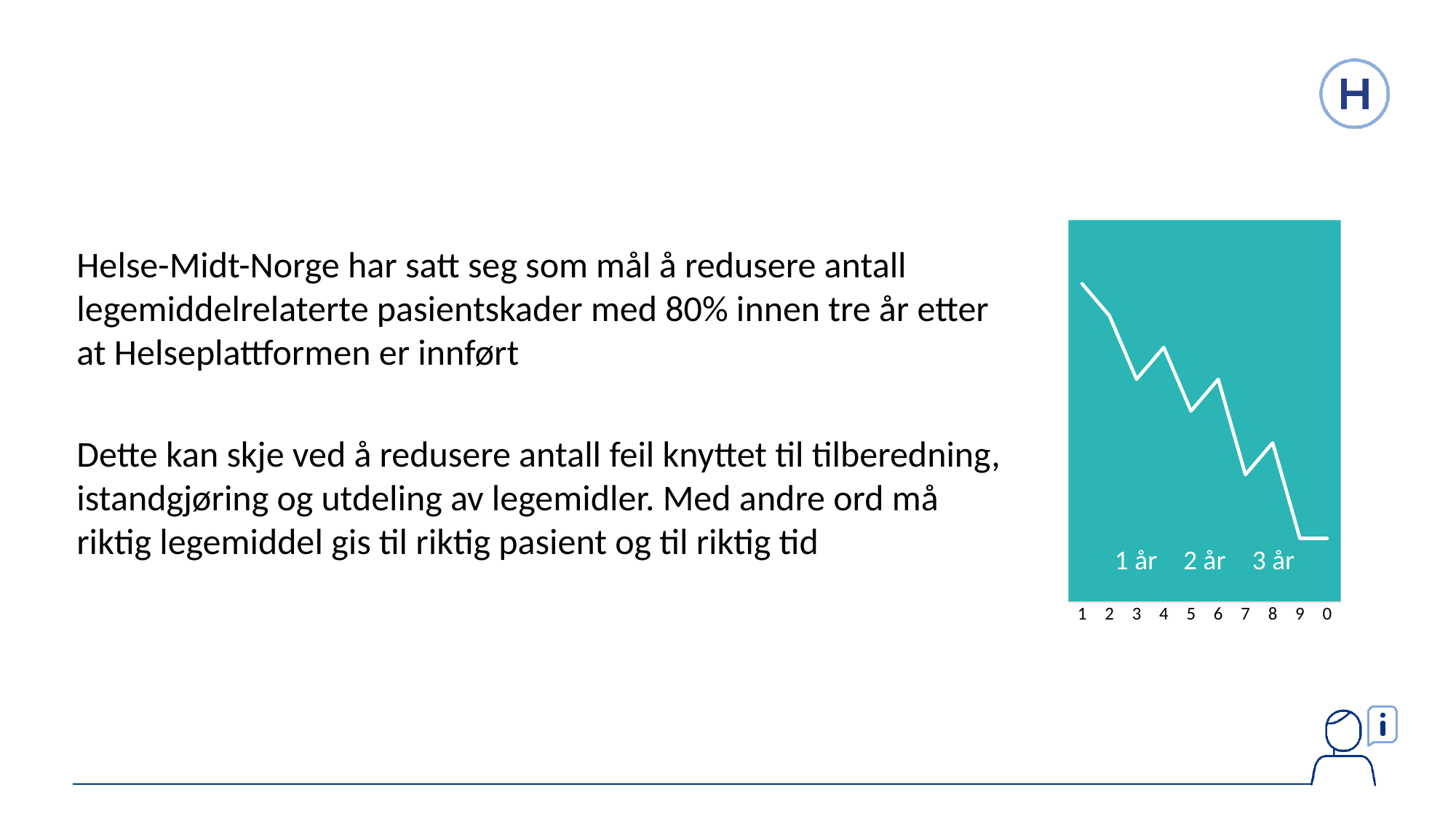
What colour is the background of the line chart? teal Do the values in the line chart generally rise or fall from left to right? fall How many numbered tick labels are shown along the x axis of the line chart? 10 Which year labels are printed inside the line chart area? 1 år, 2 år, 3 år What kind of chart is shown on the right side of the slide? line chart At which x-axis tick label is the line at its highest point? 1